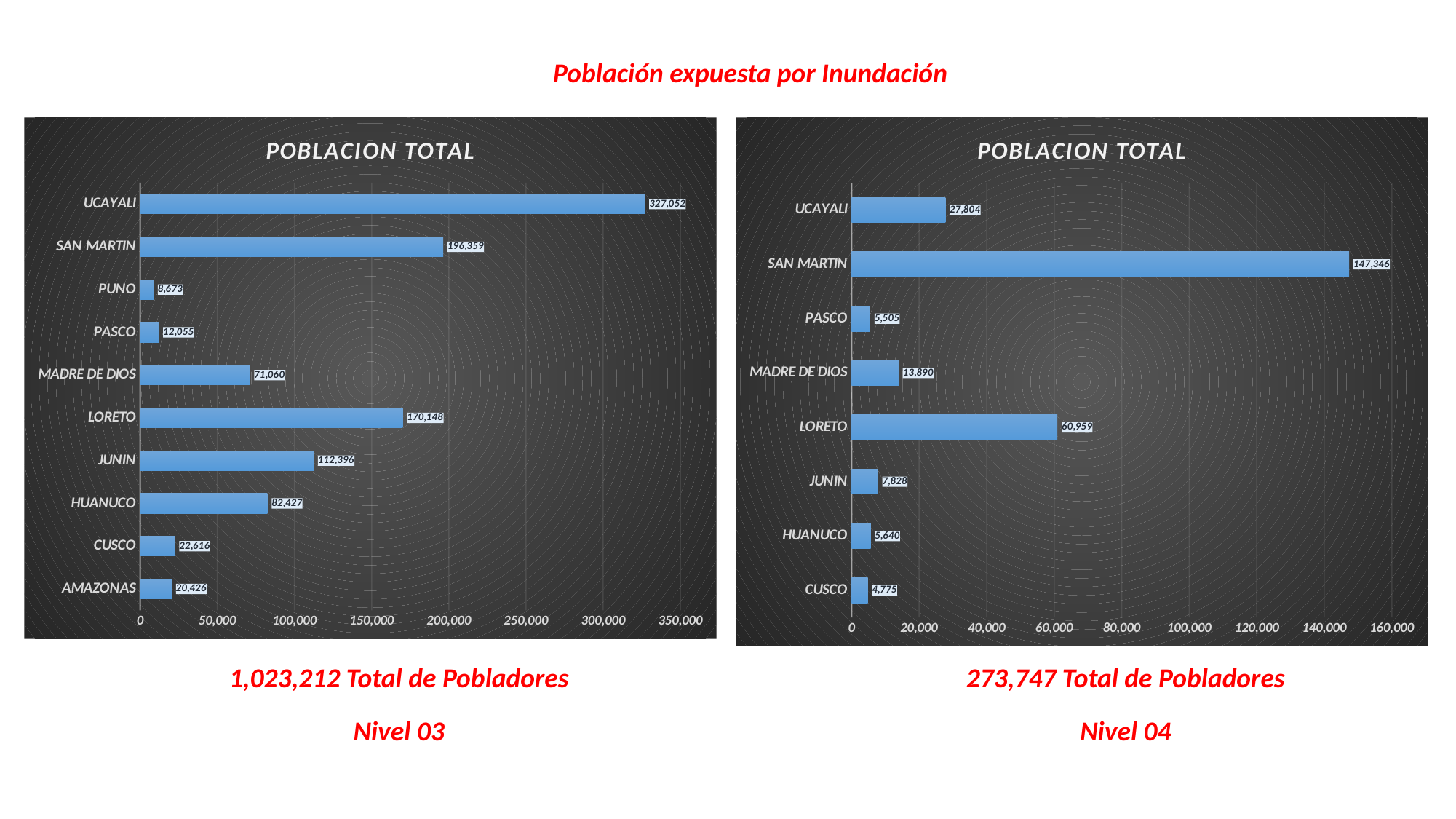
What kind of chart is the right chart (Nivel 04)? bar chart On the right chart (Nivel 04), what is the difference between the values for SAN MARTIN and LORETO? 86,387 On the left chart (Nivel 03), what is the difference between the values for UCAYALI and SAN MARTIN? 130,693 On the right chart (Nivel 04), which category has the lowest value? CUSCO On the left chart (Nivel 03), what is the value for UCAYALI? 327,052 How many categories are shown on the left chart (Nivel 03)? 10 On the right chart (Nivel 04), which category has the highest value? SAN MARTIN On the right chart (Nivel 04), what is the value for LORETO? 60,959 On the left chart (Nivel 03), which is larger, the value for LORETO or the value for JUNIN? LORETO On the left chart (Nivel 03), which category has the lowest value? PUNO On the left chart (Nivel 03), what is the value for MADRE DE DIOS? 71,060 On the right chart (Nivel 04), is the value for UCAYALI greater or less than 20,000? greater